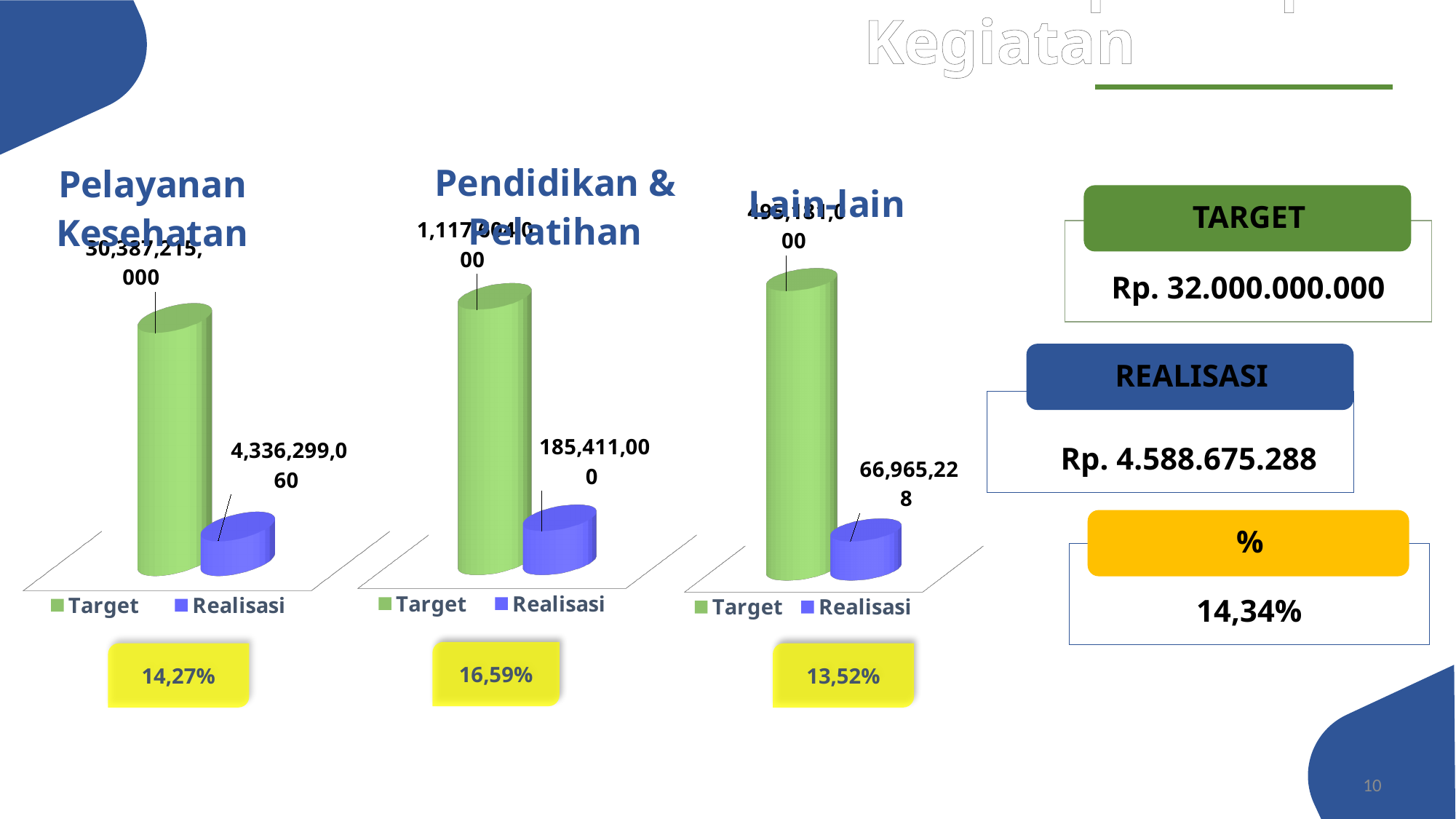
In the Pendidikan & Pelatihan chart, what is the value of the Realisasi bar? 185,411,000 In the Pelayanan Kesehatan chart, which is larger, Target or Realisasi? Target In the Lain-lain chart, what is the value of the Realisasi bar? 66,965,228 In the Pelayanan Kesehatan chart, what is the value of the Target bar? 30,387,215,000 In the Pendidikan & Pelatihan chart, which series has the lowest value? Realisasi How many bars are plotted in the Pendidikan & Pelatihan chart? 2 In the Pelayanan Kesehatan chart, what is the difference between the Target and Realisasi values? 26,050,915,940 In the Pelayanan Kesehatan chart, what is the value of the Realisasi bar? 4,336,299,060 What kind of chart is the Pelayanan Kesehatan chart? Bar chart In the Lain-lain chart, which bar is taller, Target or Realisasi? Target In the Pelayanan Kesehatan chart, what colour is the Realisasi bar? Blue How many series does the legend of the Lain-lain chart list? 2